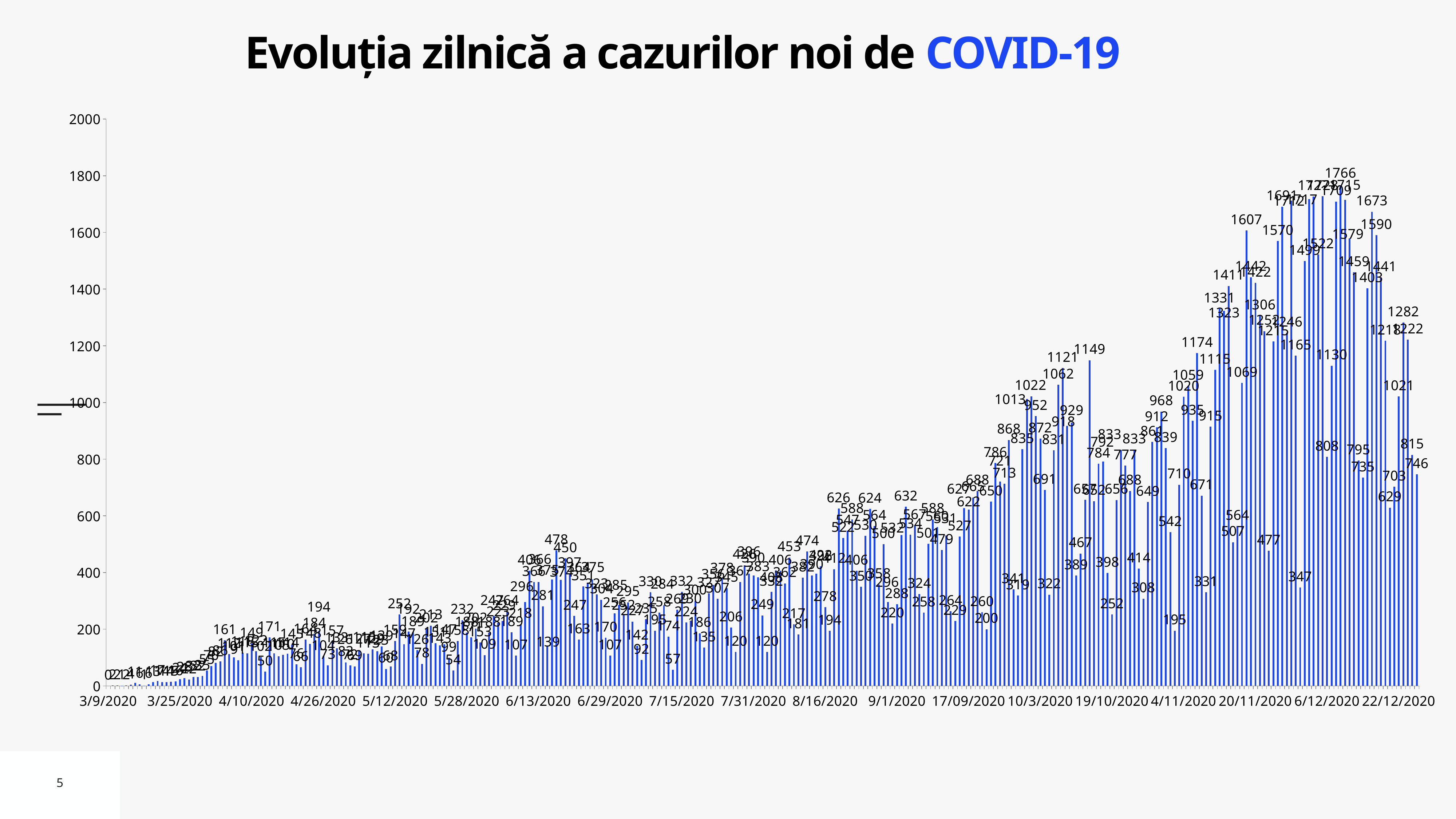
What is the title of the chart? Evoluția zilnică a cazurilor noi de COVID-19 What is the value of the tallest bar in the chart? 1766 Overall, do the daily values rise or fall from 3/9/2020 to 22/12/2020? rise What is the difference between the tallest bar (1766) and the bar labelled 1607? 159 Is the value of the first bar (3/9/2020) greater or less than 200? less Is the tallest bar around 6/13/2020 greater or less than 400? greater How many date labels are shown on the x axis? 19 Which is larger: the peak bar around 6/13/2020 or the peak bar around 17/09/2020? the peak around 17/09/2020 What kind of chart is shown on the slide? bar chart What is the highest value shown on the vertical axis? 2000